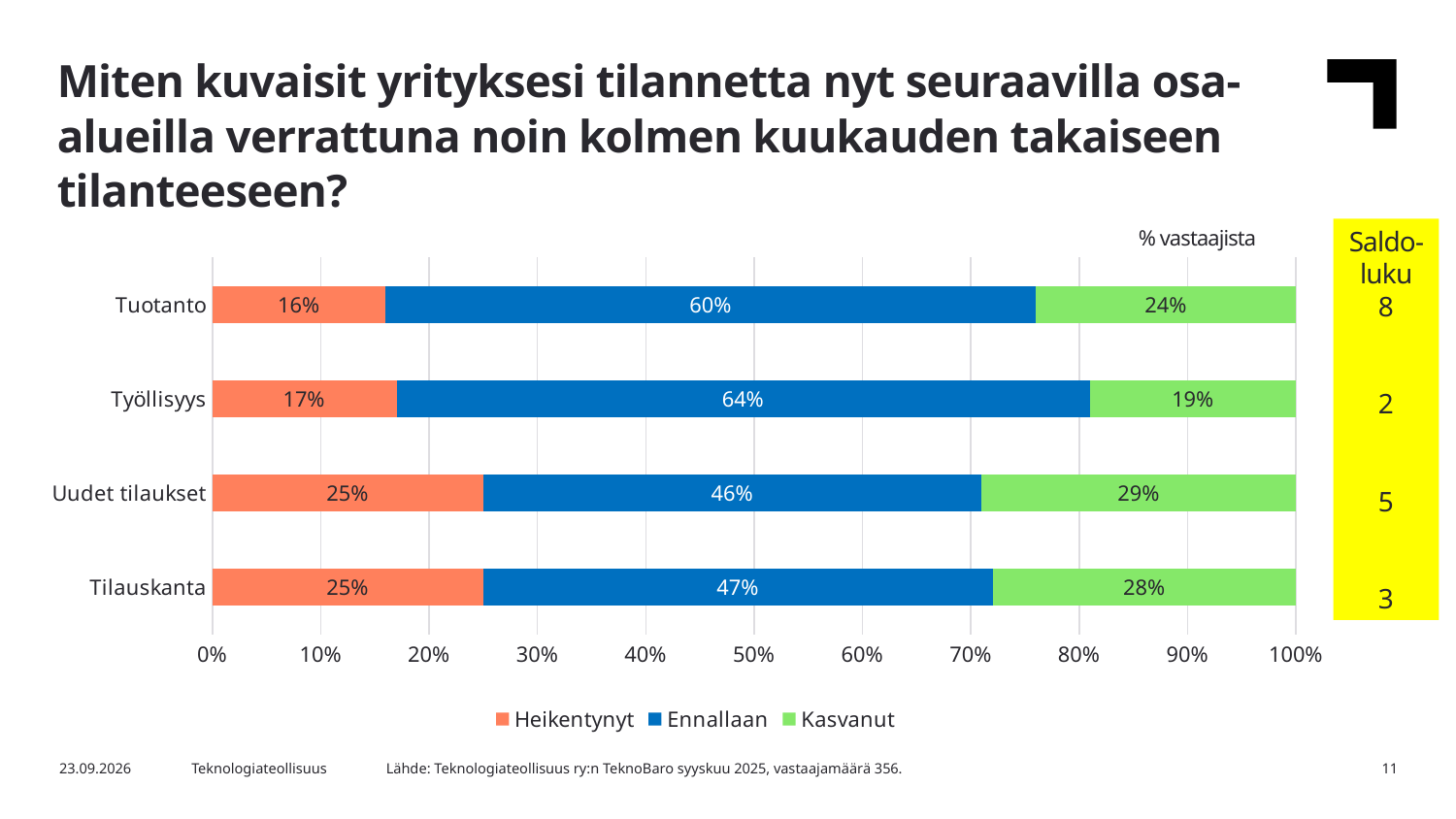
What is the total of the stacked bar for Uudet tilaukset? 100% What is the difference between the "Ennallaan" values for Tuotanto and Tilauskanta? 13% What percentage of respondents answered "Ennallaan" for Tuotanto? 60% What is the "Kasvanut" value for Uudet tilaukset? 29% Which is larger: the "Kasvanut" value for Tuotanto or for Tilauskanta? Tilauskanta How many series does the legend list? 3 How many categories are shown on the y axis of the chart? 4 What is the "Heikentynyt" value for Työllisyys? 17% What are the three legend entries of the chart? Heikentynyt, Ennallaan, Kasvanut What kind of chart is shown on the slide? Stacked bar chart Which category has the highest "Ennallaan" share? Työllisyys Which category has the lowest "Kasvanut" share? Työllisyys